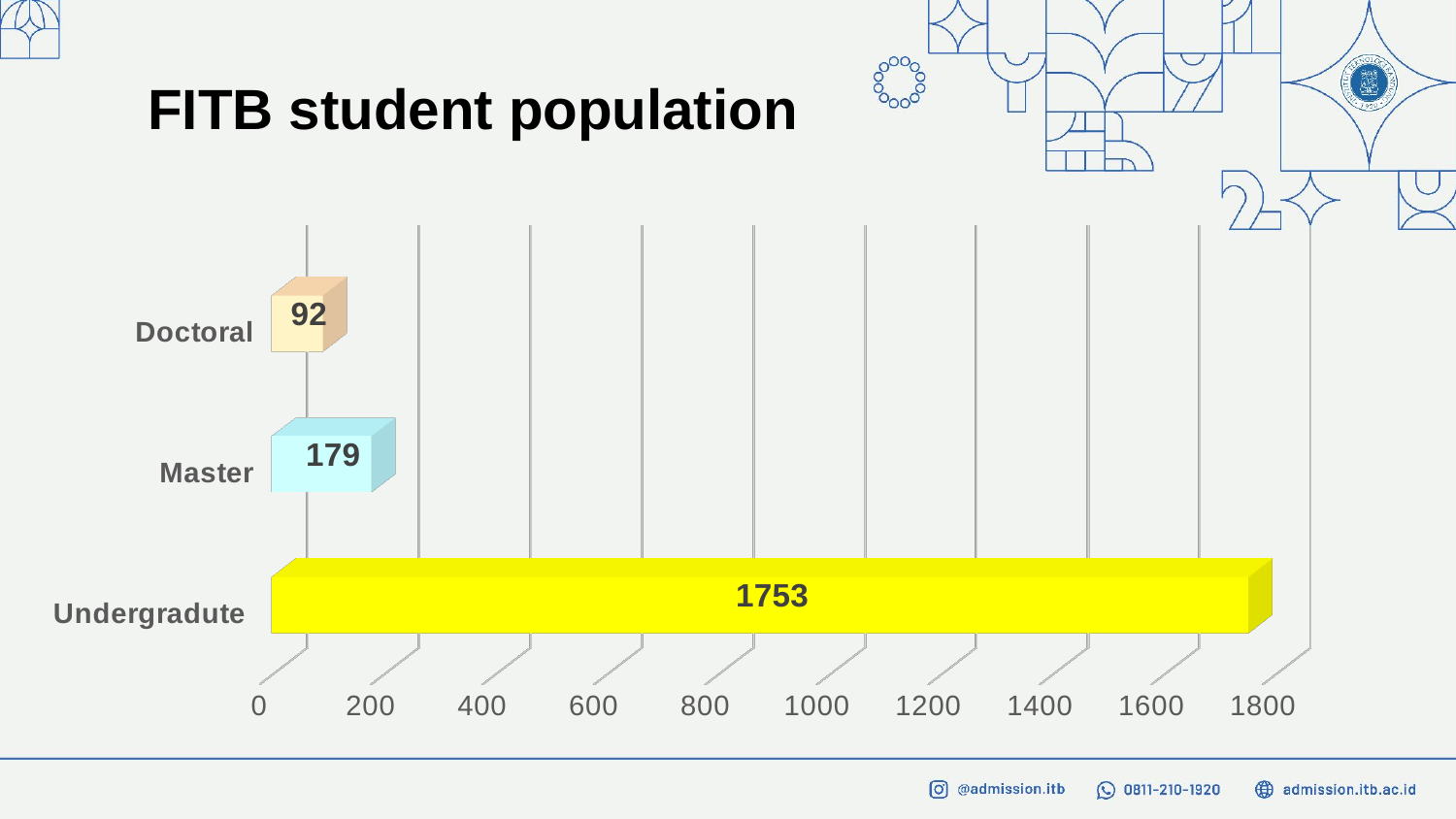
Is the value for Undergradute greater or less than 1600? greater What kind of chart is shown on the slide? bar chart What is the difference between the Master and Doctoral values? 87 Which category has the highest value? Undergradute Which category has the lowest value? Doctoral What is the value for Doctoral? 92 How many categories are shown in the chart? 3 What is the title of the chart? FITB student population Which is larger, the value for Master or the value for Doctoral? Master What is the value for Undergradute? 1753 What is the value for Master? 179 What is the difference between the Undergradute and Master values? 1574